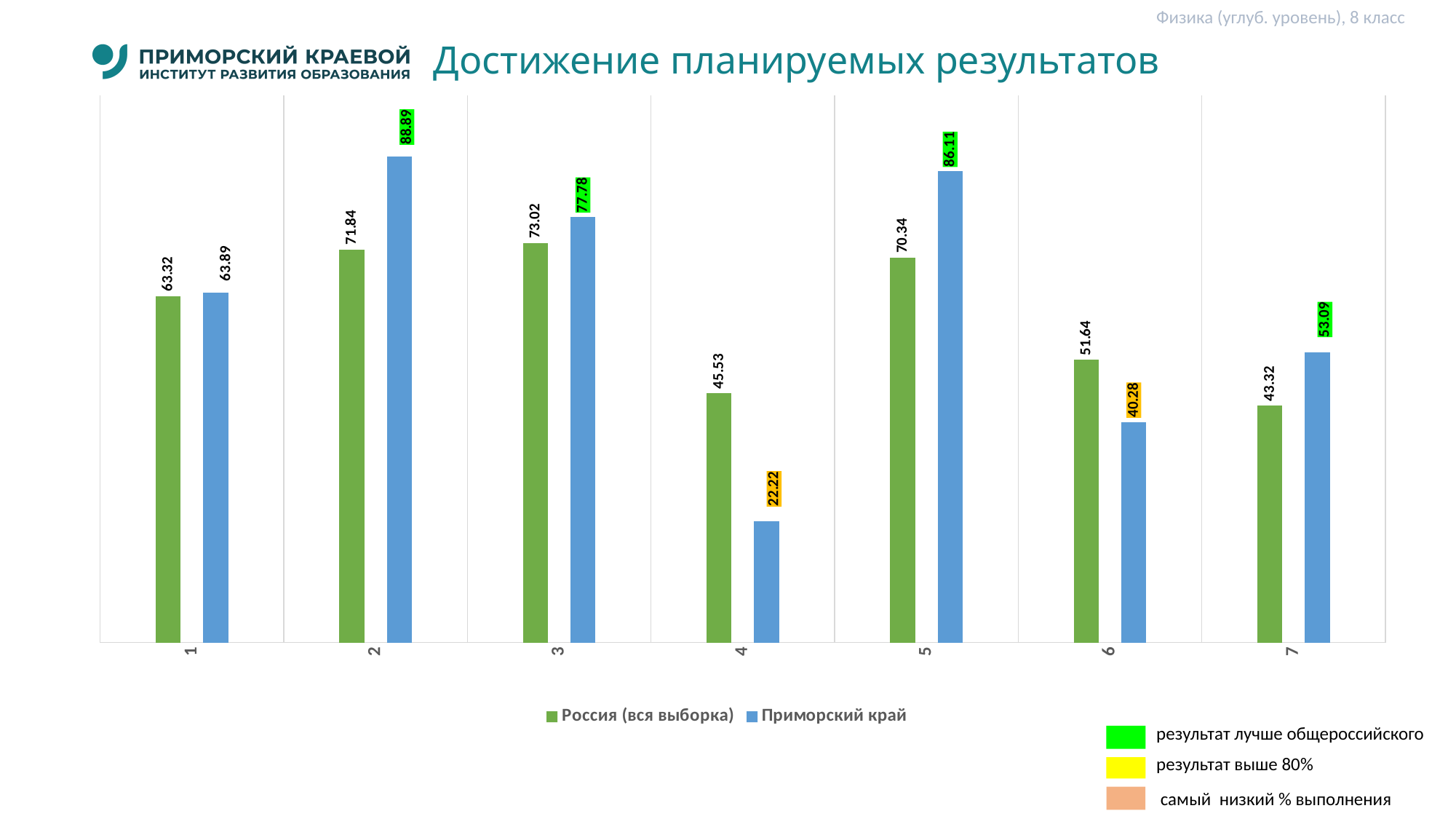
What is the value for Россия (вся выборка) for category 4? 45.53 What kind of chart is shown on the slide? bar chart What is the title of the chart on the slide? Достижение планируемых результатов What is the difference between the Приморский край and Россия (вся выборка) values for category 4? 23.31 Which category has the highest value for Приморский край? 2 What is the value for Приморский край for category 7? 53.09 How many series does the legend list? 2 For category 6, which series has the larger value: Россия (вся выборка) or Приморский край? Россия (вся выборка) What is the value for Приморский край for category 2? 88.89 How many categories are shown on the x axis? 7 Which category has the lowest value for Россия (вся выборка)? 7 Which category has the lowest value for Приморский край? 4